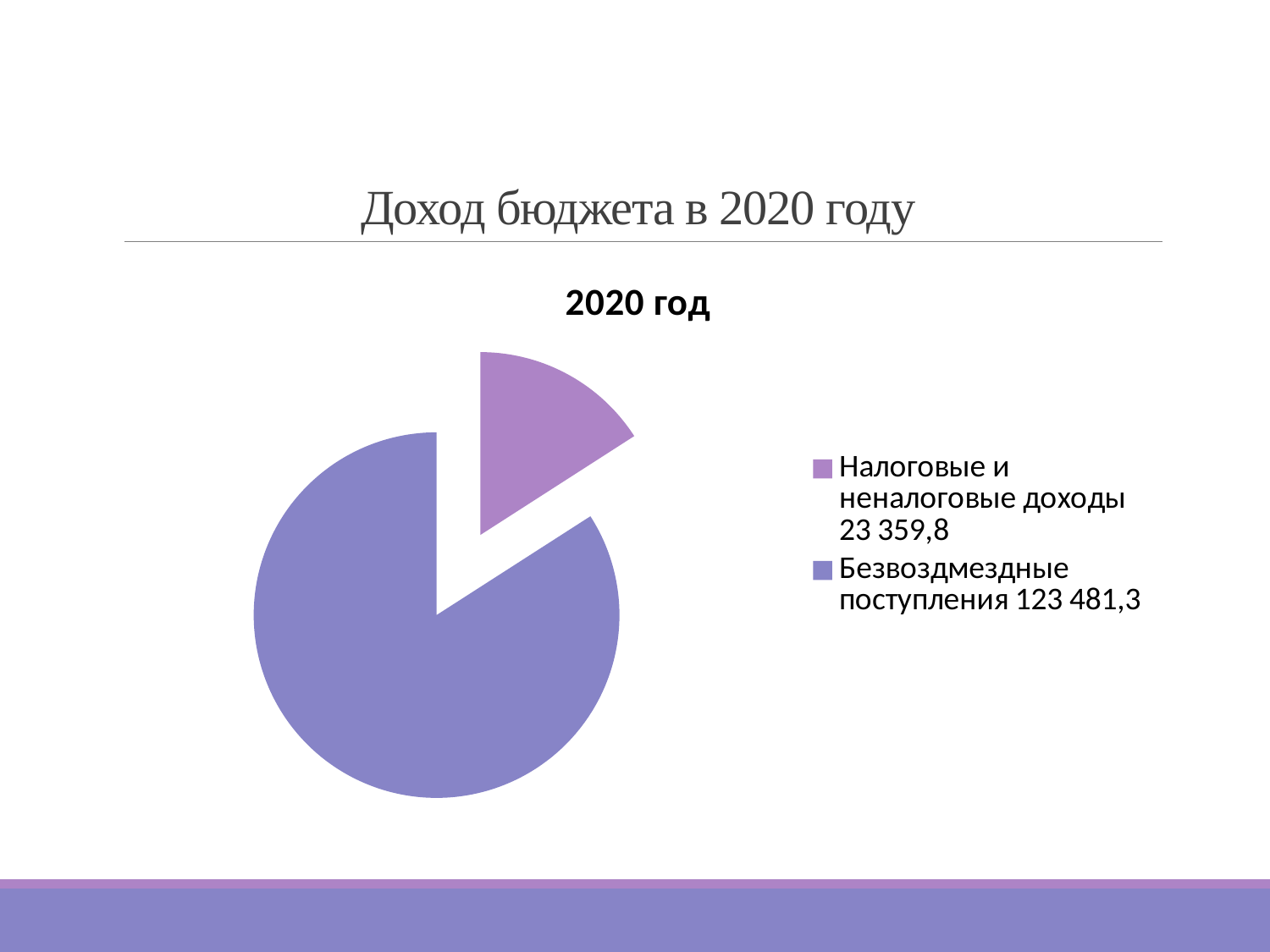
What is the total of the two categories in the pie chart? 146 841,1 How many entries does the legend list? 2 Which is larger: Налоговые и неналоговые доходы or Безвоздмездные поступления? Безвоздмездные поступления What kind of chart is shown on the slide? pie chart What value is given for Безвоздмездные поступления? 123 481,3 What is the title of the chart? 2020 год What is the difference between Безвоздмездные поступления and Налоговые и неналоговые доходы? 100 121,5 How many slices does the pie chart have? 2 Which category has the largest slice of the pie? Безвоздмездные поступления What value is given for Налоговые и неналоговые доходы? 23 359,8 Which colour represents Налоговые и неналоговые доходы in the pie chart? light purple (pink-purple) Which category has the smallest slice of the pie? Налоговые и неналоговые доходы